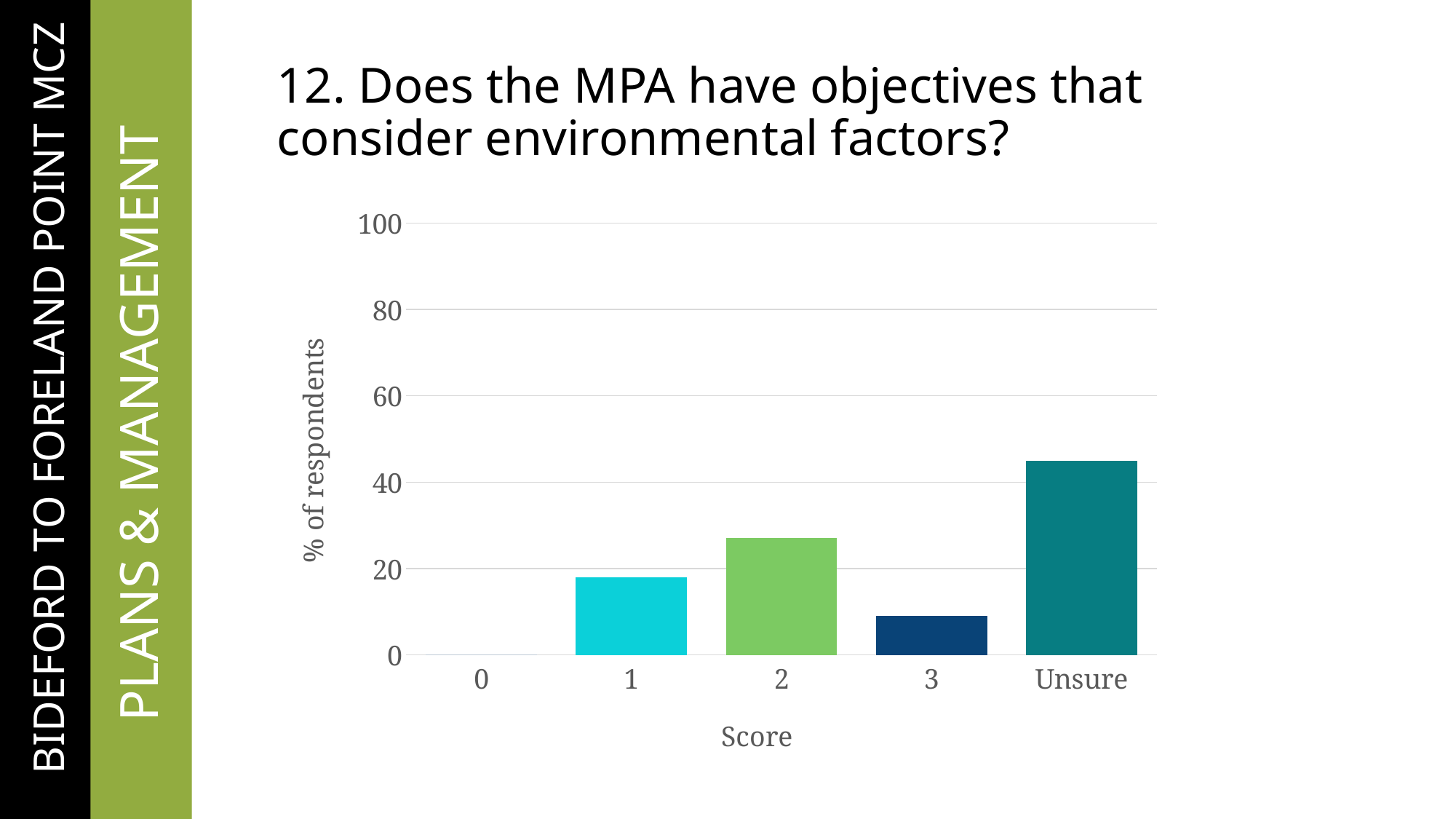
Which score category has the lowest percentage of respondents? 0 Which has a higher percentage of respondents, score 3 or Unsure? Unsure Is the value for score 3 greater or less than 20? less Is the value for Unsure greater or less than 60? less What is the label of the y axis? % of respondents What kind of chart is shown on the slide? bar chart How many score categories are shown on the x axis? 5 Which has a higher percentage of respondents, score 1 or score 2? 2 Is the value for score 2 greater or less than 20? greater What is the label of the x axis? Score Which score category has the highest percentage of respondents? Unsure